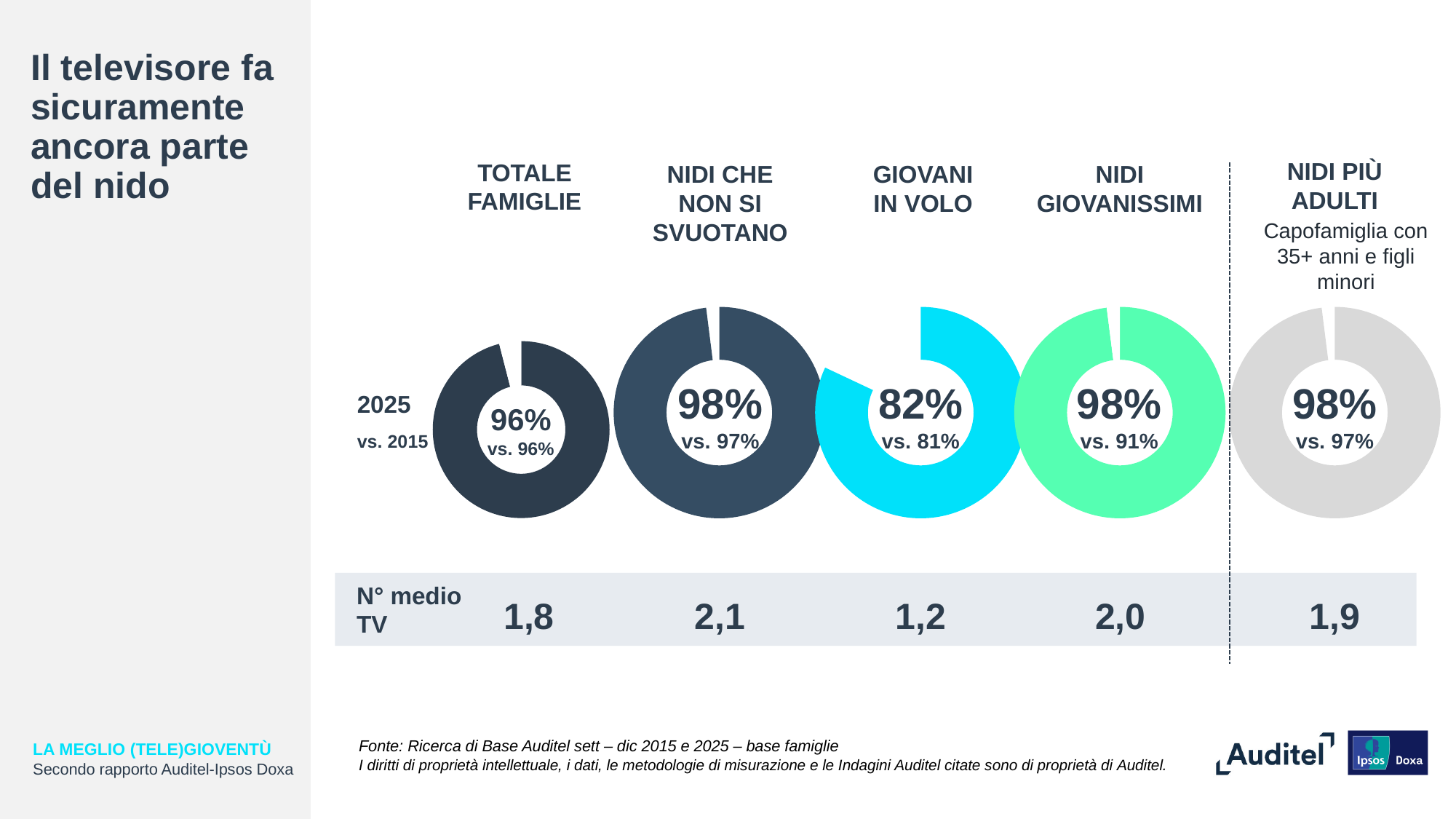
What is the N° medio TV value for NIDI CHE NON SI SVUOTANO? 2,1 What kind of chart is used to show the percentages for each family group? Donut chart What is the 2025 value shown in the TOTALE FAMIGLIE donut chart? 96% Which group has the lowest N° medio TV value? GIOVANI IN VOLO Which of the five donut charts shows the lowest 2025 percentage? GIOVANI IN VOLO What colour is the GIOVANI IN VOLO donut chart? Cyan (light blue) By how many percentage points did the NIDI GIOVANISSIMI value change from 2015 to 2025? 7 percentage points What was the 2015 value shown under the NIDI PIÙ ADULTI donut chart? 97% What is the 2025 value shown in the GIOVANI IN VOLO donut chart? 82% Is the 2025 value for GIOVANI IN VOLO larger or smaller than the 2025 value for NIDI CHE NON SI SVUOTANO? Smaller What was the 2015 value shown under the NIDI GIOVANISSIMI donut chart? 91% How many donut charts are shown on the slide? 5